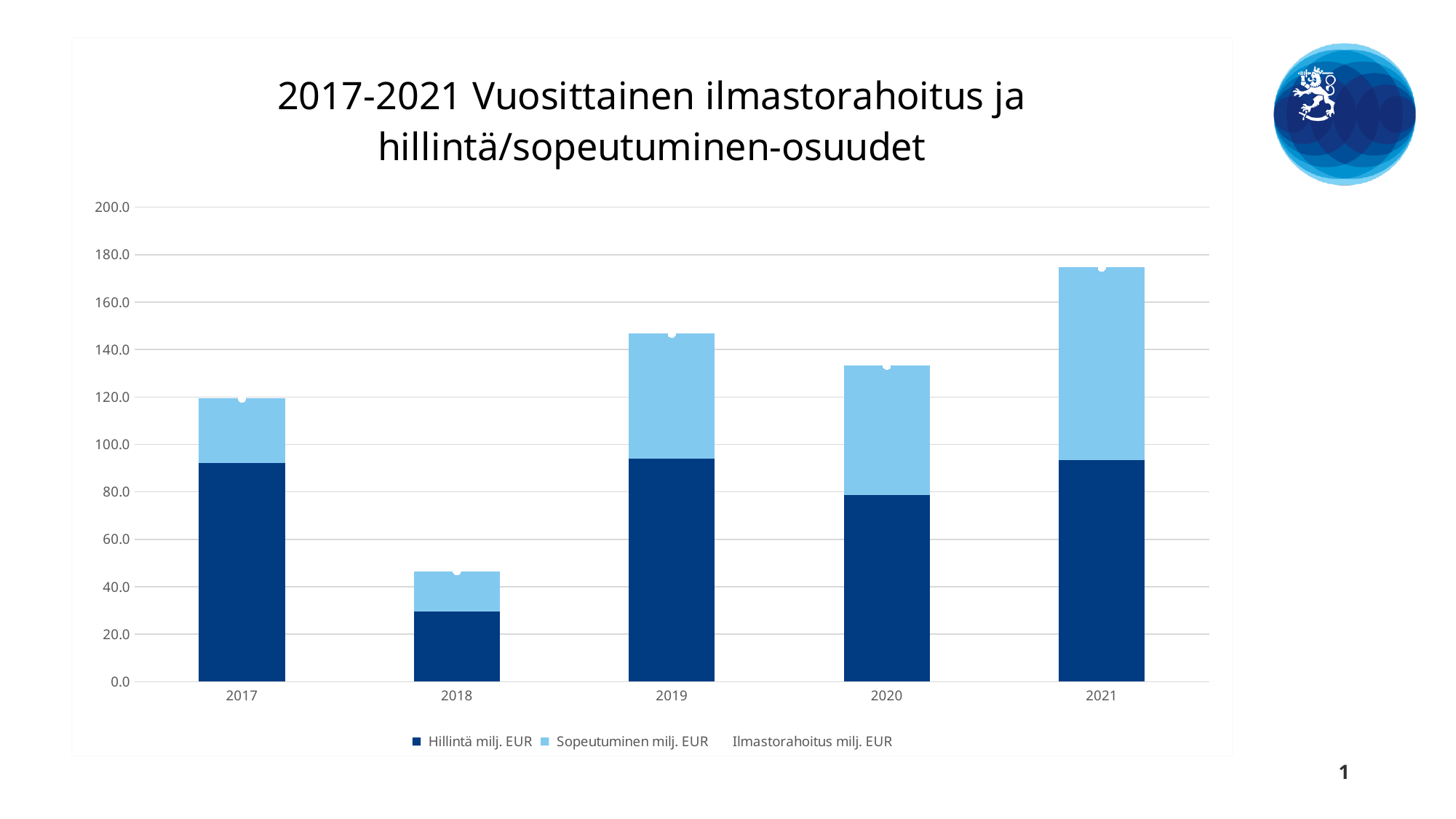
Is the total height of the 2020 bar greater or less than 120? greater How many entries does the chart's legend list? 3 Does the total bar height rise or fall from 2019 to 2020? fall Which year has the shortest stacked bar (lowest total climate finance)? 2018 Is the Hillintä milj. EUR segment for 2017 greater or less than 80? greater Is the total height of the 2018 bar greater or less than 60? less What colour represents Hillintä milj. EUR in the chart? Dark blue What kind of chart is shown on the slide? Stacked bar chart Which year has the larger Sopeutuminen milj. EUR segment, 2017 or 2021? 2021 How many years are shown on the x axis of the chart? 5 Which year has the tallest stacked bar (highest total climate finance)? 2021